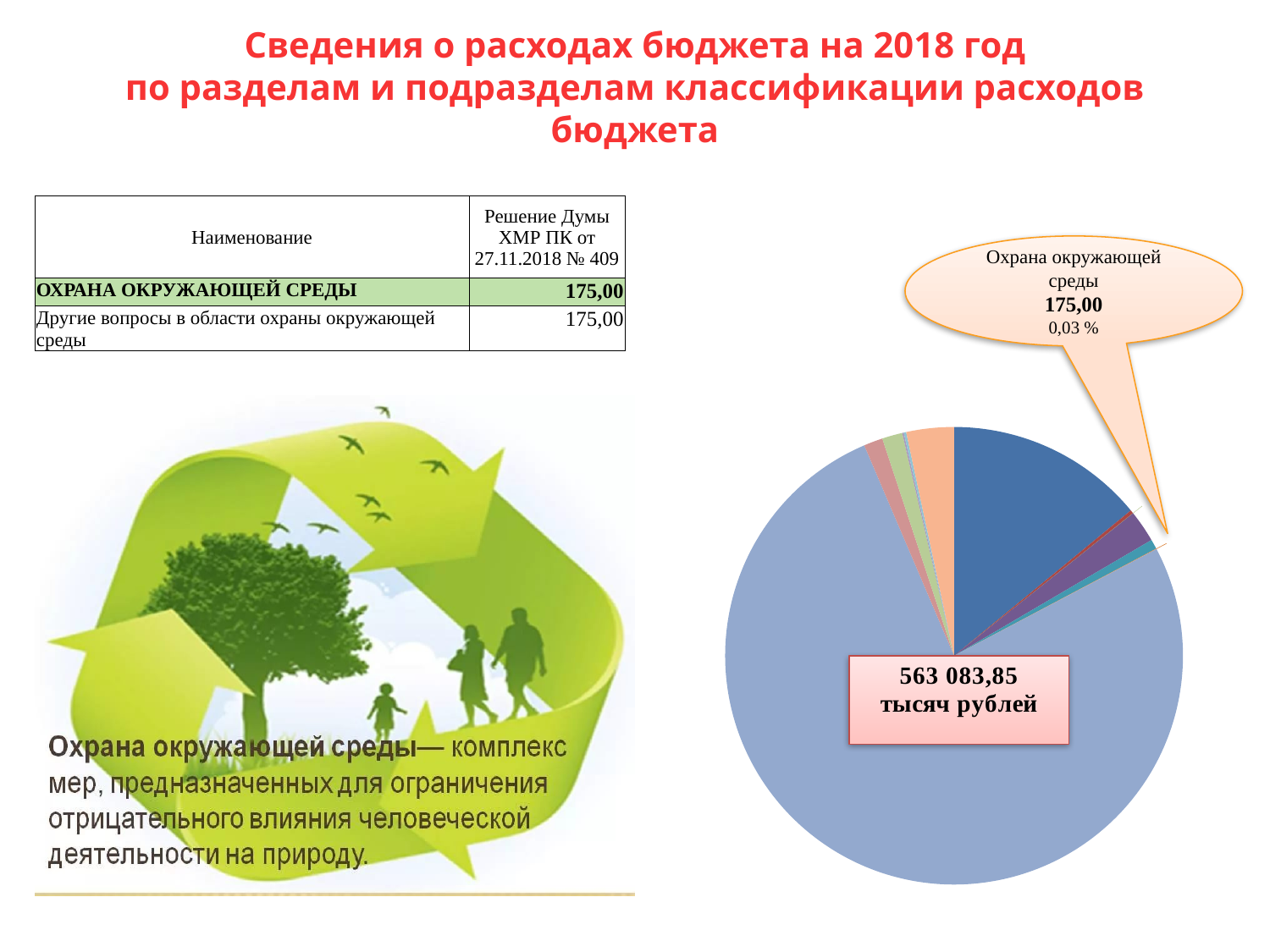
According to the callout on the pie chart, what is the value for Охрана окружающей среды? 175,00 Does the pie chart include a legend listing its categories? No Is the share of the Охрана окружающей среды slice greater or less than 1 %? less What total amount is printed in the box in the centre of the pie chart? 563 083,85 тысяч рублей Which colour slice occupies the largest part of the pie chart? light blue Is the Охрана окружающей среды slice larger or smaller than the dark blue slice of the pie? smaller What share of the pie does the Охрана окружающей среды slice represent, according to the callout? 0,03 % What kind of chart is shown on the right side of the slide? pie chart